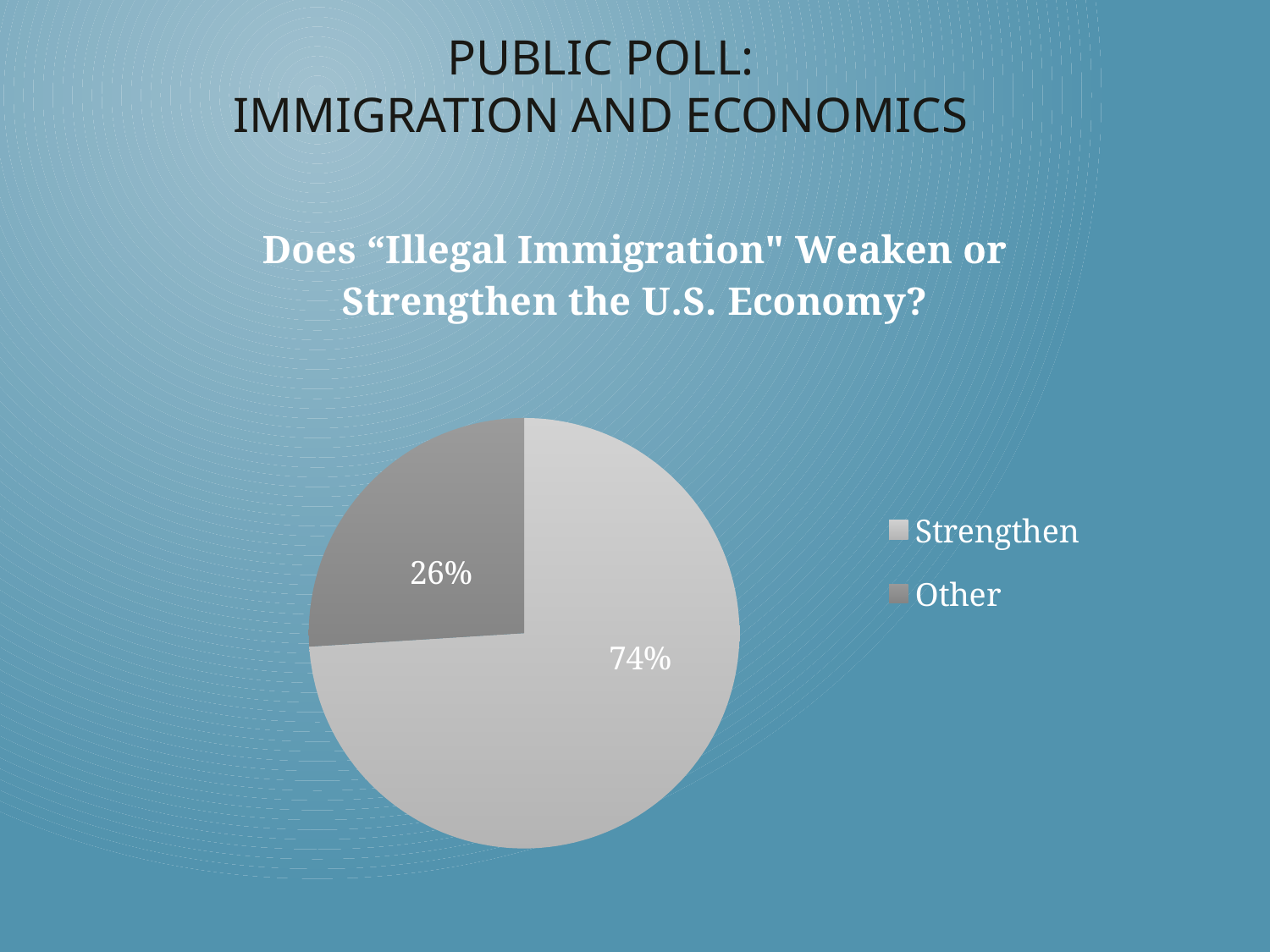
How many slices does the pie chart have? 2 What share of the pie does the Strengthen slice represent? 74% What is the title of the chart? Does "Illegal Immigration" Weaken or Strengthen the U.S. Economy? Which is larger, the Strengthen slice or the Other slice? Strengthen Which slice of the pie is the smallest? Other Which slice of the pie is the largest? Strengthen What kind of chart is shown on the slide? pie chart How many entries does the legend list? 2 Which legend entry is shown in the darker grey colour? Other What is the difference in percentage points between the Strengthen and Other slices? 48 What share of the pie does the Other slice represent? 26%